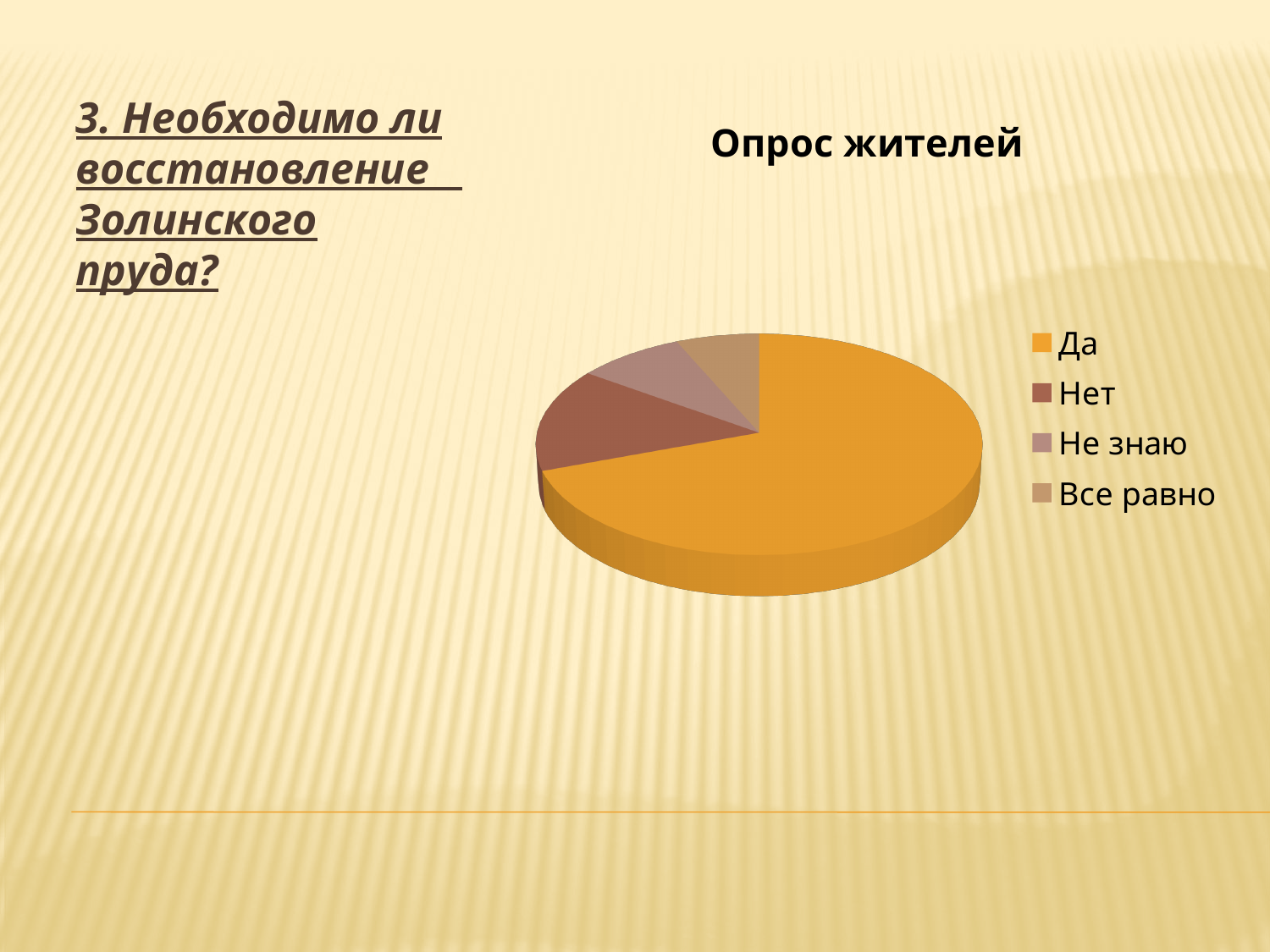
Which slice is larger, Нет or Не знаю? Нет Does the Да slice take up more or less than half of the pie? more Which slice is larger, Да or Нет? Да How many categories does the pie chart have? 4 Which slice is larger, Нет or Все равно? Нет Which category has the largest slice of the pie? Да What is the title of the chart? Опрос жителей What kind of chart is shown on the slide? pie chart Which category is shown in orange in the pie chart? Да